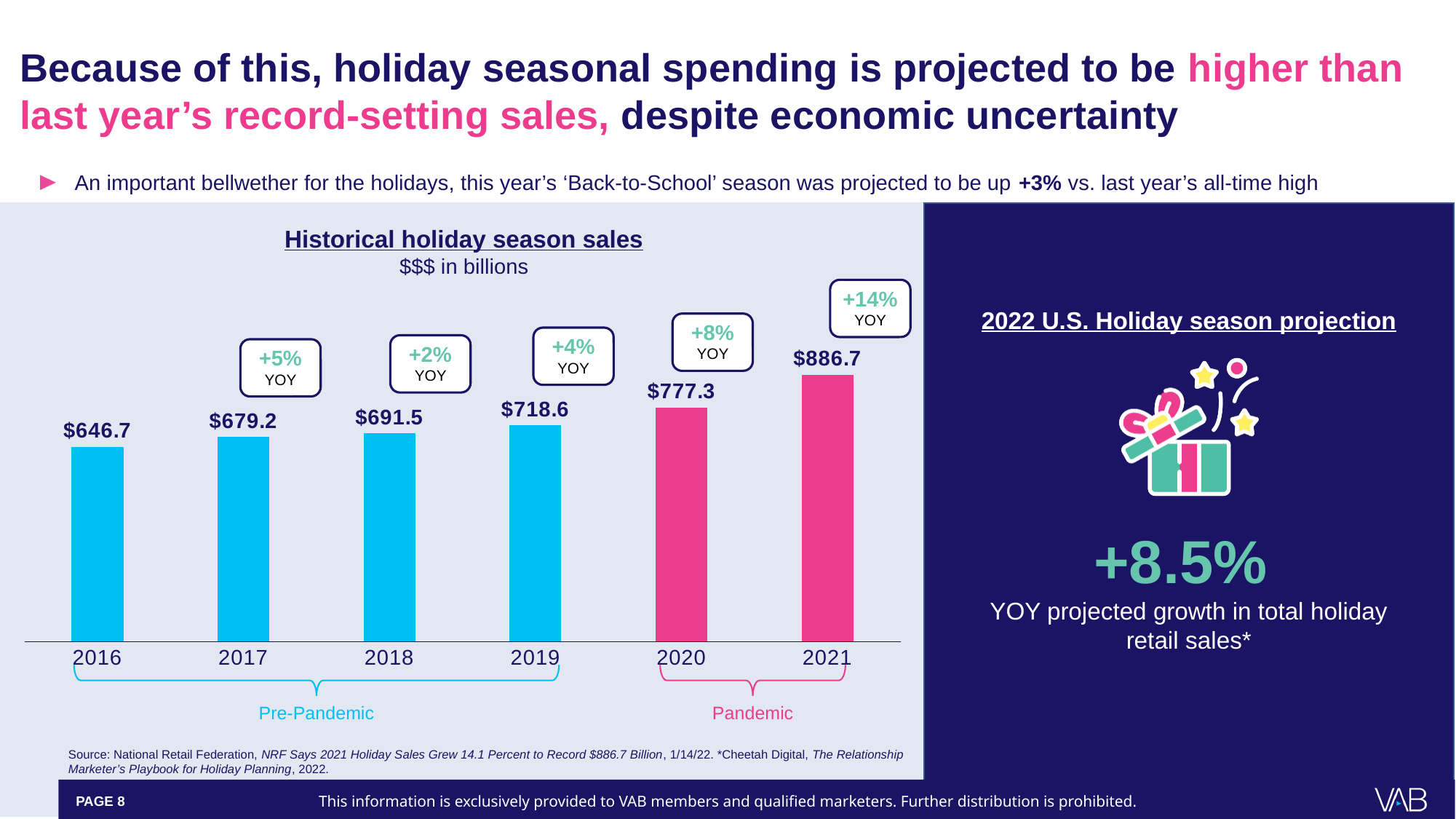
What was the holiday season sales value for 2019? $718.6 What was the holiday season sales value for 2021? $886.7 Which year has the highest holiday season sales? 2021 Which year had higher holiday season sales, 2017 or 2020? 2020 Do holiday season sales rise or fall from 2016 to 2021? Rise What type of chart is used to show historical holiday season sales? Bar chart What YOY growth percentage is shown above the 2021 bar? +14% What was the holiday season sales value for 2016? $646.7 What is the difference in holiday season sales between 2021 and 2020? $109.4 How many years are shown in the Historical holiday season sales chart? 6 Which year has the lowest holiday season sales? 2016 What is the difference in holiday season sales between 2019 and 2018? $27.1